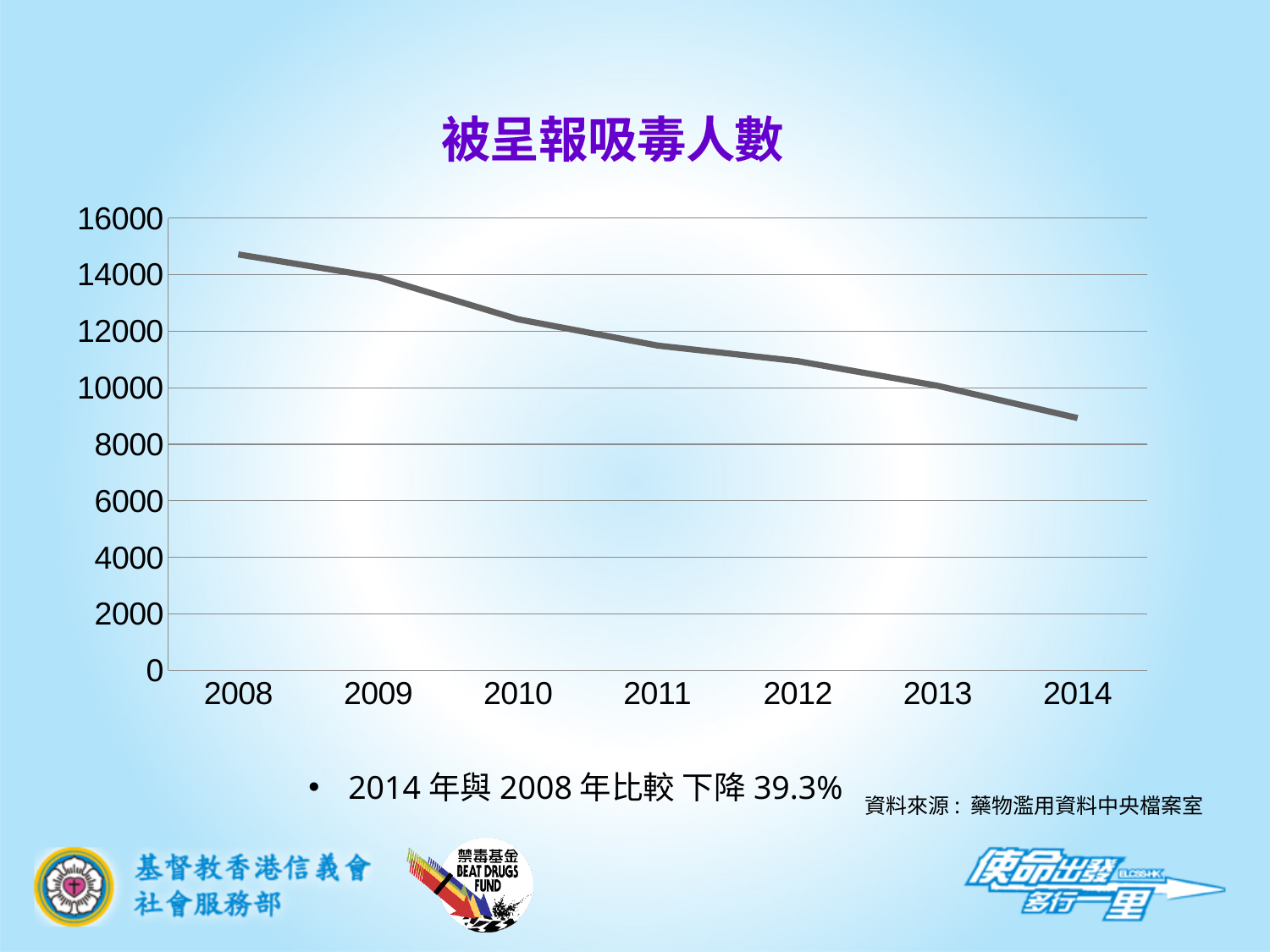
Is the value for 2008 greater or less than 14000? greater Which year has the highest value? 2008 Is the value for 2012 greater or less than 10000? greater Is the value for 2011 greater or less than 12000? less What is the title of the chart? 被呈報吸毒人數 Which year has the lowest value? 2014 What kind of chart is shown on the slide? line chart Which year has the larger value, 2009 or 2013? 2009 Do the values rise or fall from 2008 to 2014? fall How many years are plotted on the x axis? 7